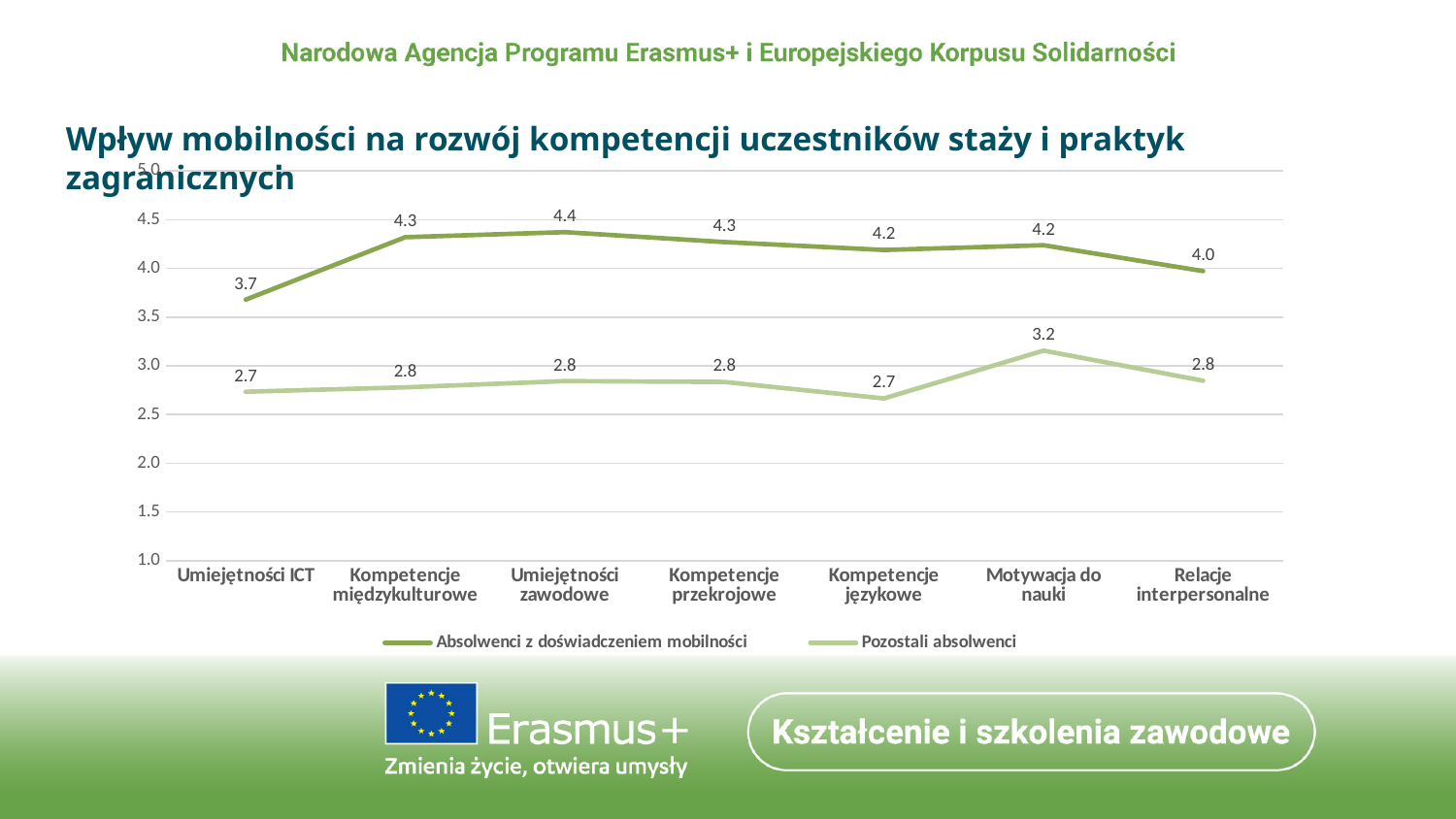
How many series does the legend list? 2 Which category has the highest value in the Absolwenci z doświadczeniem mobilności series? Umiejętności zawodowe Which series has the higher value for Relacje interpersonalne? Absolwenci z doświadczeniem mobilności What is the difference between the two series for Umiejętności ICT? 1.0 What kind of chart is shown on the slide? Line chart Which category has the lowest value in the Absolwenci z doświadczeniem mobilności series? Umiejętności ICT Which category has the highest value in the Pozostali absolwenci series? Motywacja do nauki What is the value for Umiejętności ICT in the Absolwenci z doświadczeniem mobilności series? 3.7 What is the value for Motywacja do nauki in the Pozostali absolwenci series? 3.2 What is the difference between the two series for Umiejętności zawodowe? 1.6 What is the value for Umiejętności zawodowe in the Absolwenci z doświadczeniem mobilności series? 4.4 How many categories are shown on the x axis? 7